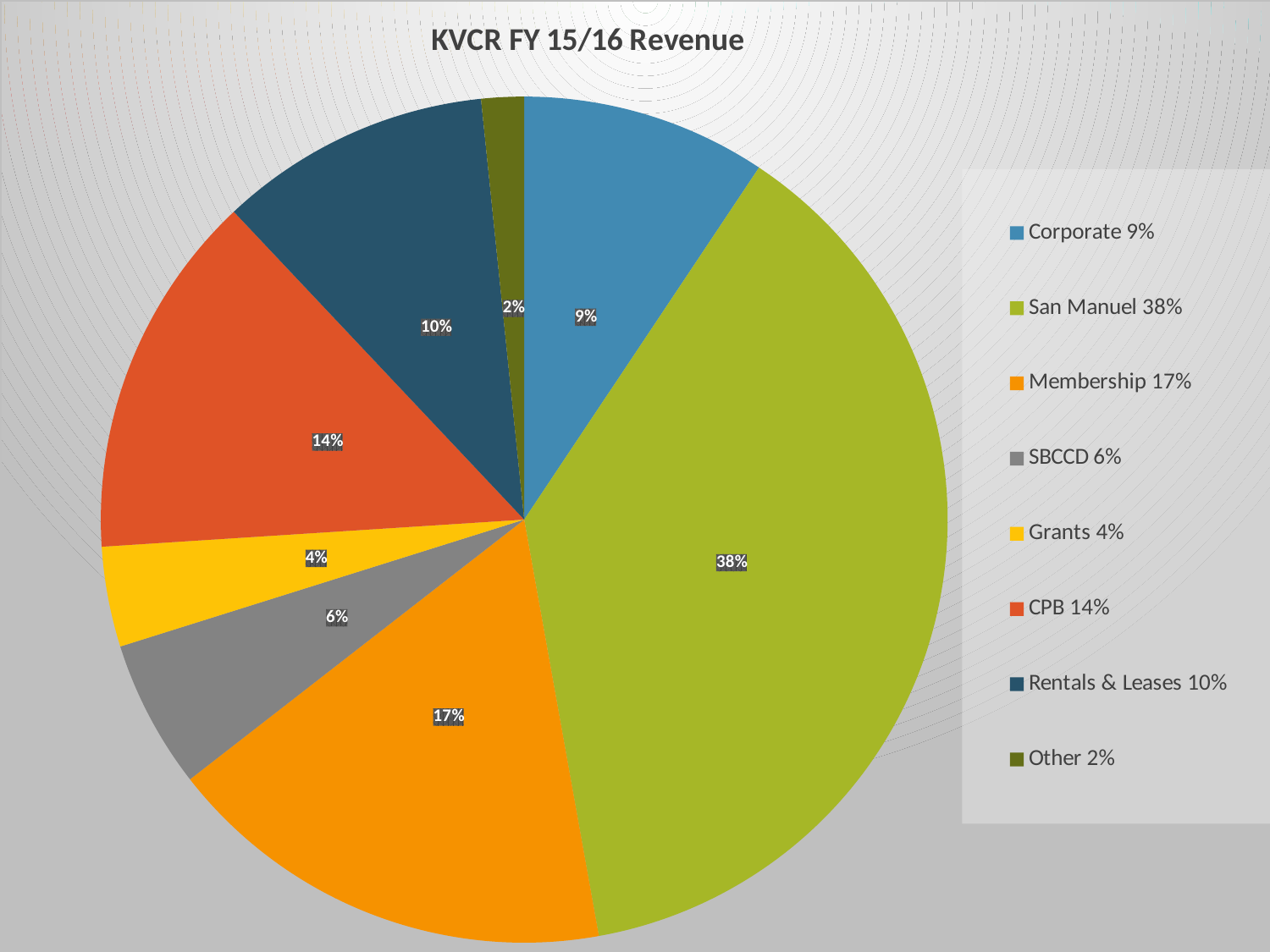
What percentage is shown for CPB? 14% What share of revenue does San Manuel account for? 38% What share of revenue comes from Membership? 17% What is the difference between the Membership share and the Corporate share? 8% Which category has the smallest share of revenue? Other What percentage is shown for Rentals & Leases? 10% How many categories does the pie chart have? 8 Which category has the largest share of revenue? San Manuel What colour is the San Manuel slice? green Which is larger, the SBCCD share or the Grants share? SBCCD What is the title of the chart? KVCR FY 15/16 Revenue What kind of chart is shown on the slide? pie chart